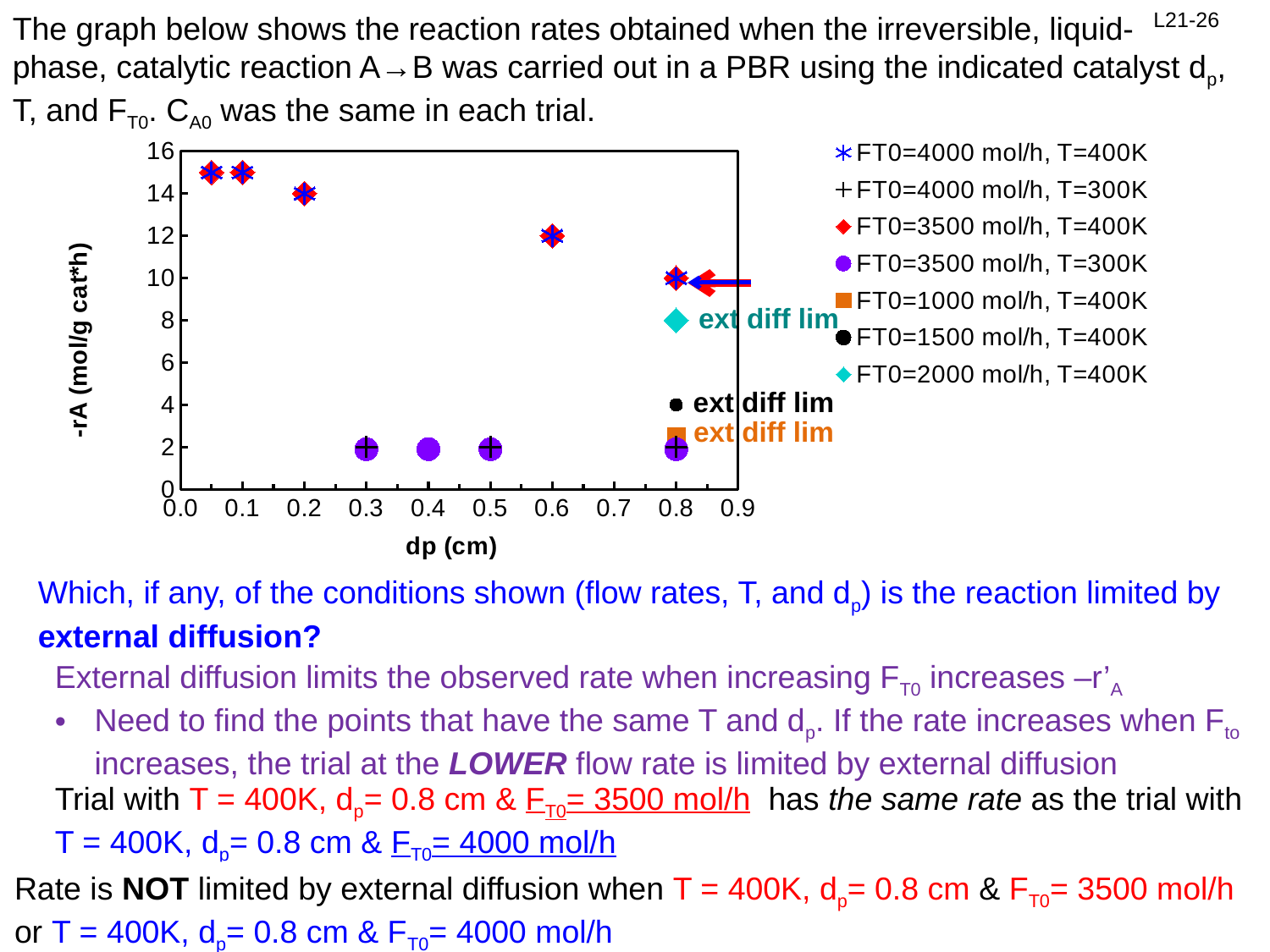
What is the label of the y axis of the chart? -rA (mol/g cat*h) What is the value for the FT0=4000 mol/h, T=400K series at dp = 0.6 cm? 12 Is the value for the FT0=1000 mol/h, T=400K series at dp = 0.8 cm greater or less than 6? less How many series does the chart legend list? 7 Is the value for the FT0=2000 mol/h, T=400K series at dp = 0.8 cm greater or less than 6? greater Is the value for the FT0=3500 mol/h, T=300K series at dp = 0.4 cm greater or less than 4? less At dp = 0.8 cm, which series has the higher rate: FT0=2000 mol/h, T=400K or FT0=1500 mol/h, T=400K? FT0=2000 mol/h, T=400K At dp = 0.8 cm, which series has the higher rate: FT0=4000 mol/h, T=400K or FT0=4000 mol/h, T=300K? FT0=4000 mol/h, T=400K What is the label of the x axis of the chart? dp (cm) What kind of chart is shown on the slide? scatter chart For the FT0=4000 mol/h, T=400K series, does the reaction rate rise or fall as dp increases? falls